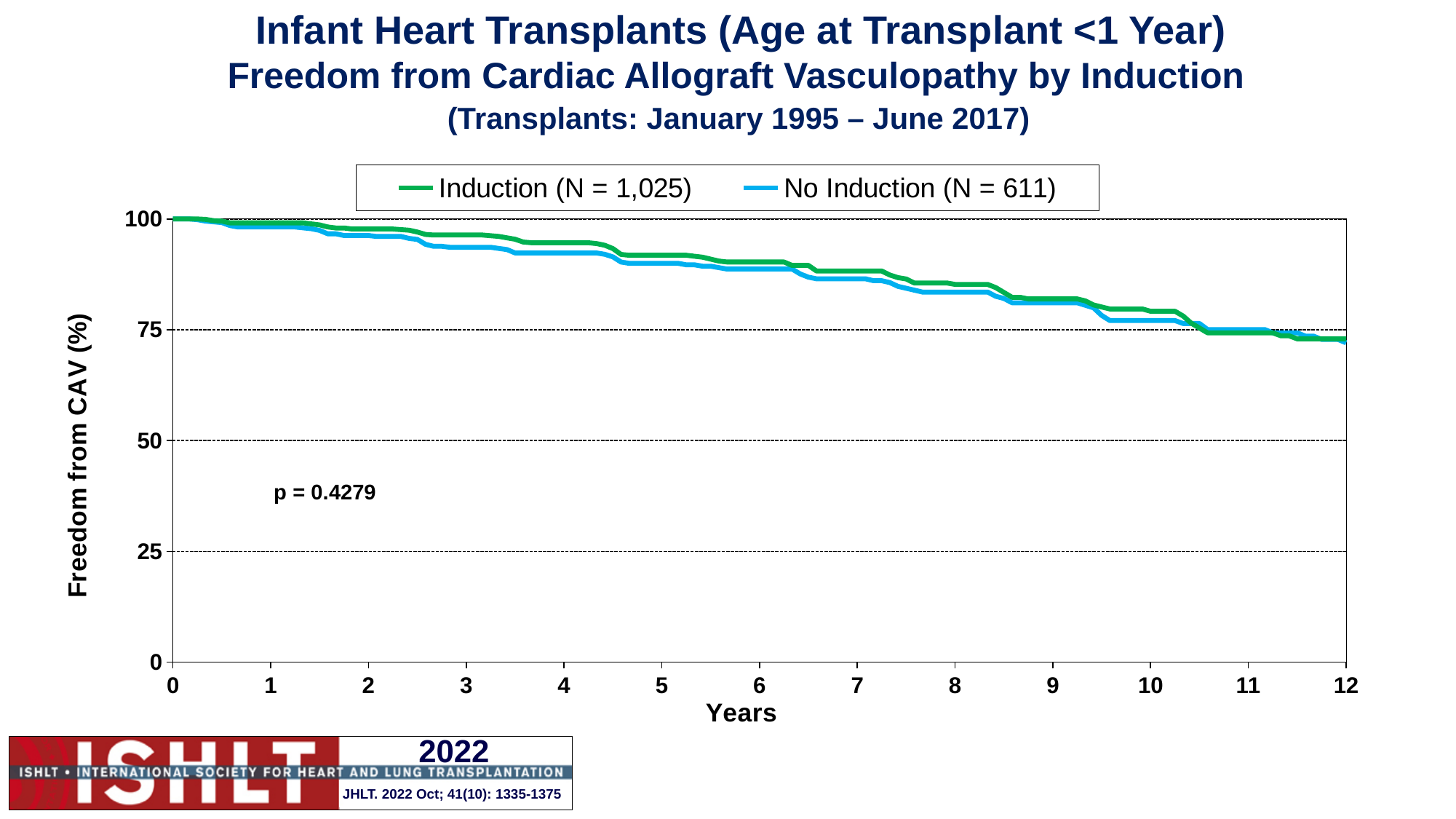
Is the value for Induction at 12 years greater or less than 75? less How many series does the legend list? 2 What p-value is shown on the chart? p = 0.4279 Is the value for No Induction at 9 years greater or less than 75? greater What is the N for the Induction group shown in the legend? 1,025 Do the values for Induction rise or fall as the years increase? Fall At 8 years, which series has the higher freedom from CAV, Induction or No Induction? Induction What kind of chart is shown on the slide? Line chart Do the values for No Induction rise or fall as the years increase? Fall Is the value for Induction at 3 years greater or less than 100? less At 5 years, which series has the higher freedom from CAV, Induction or No Induction? Induction